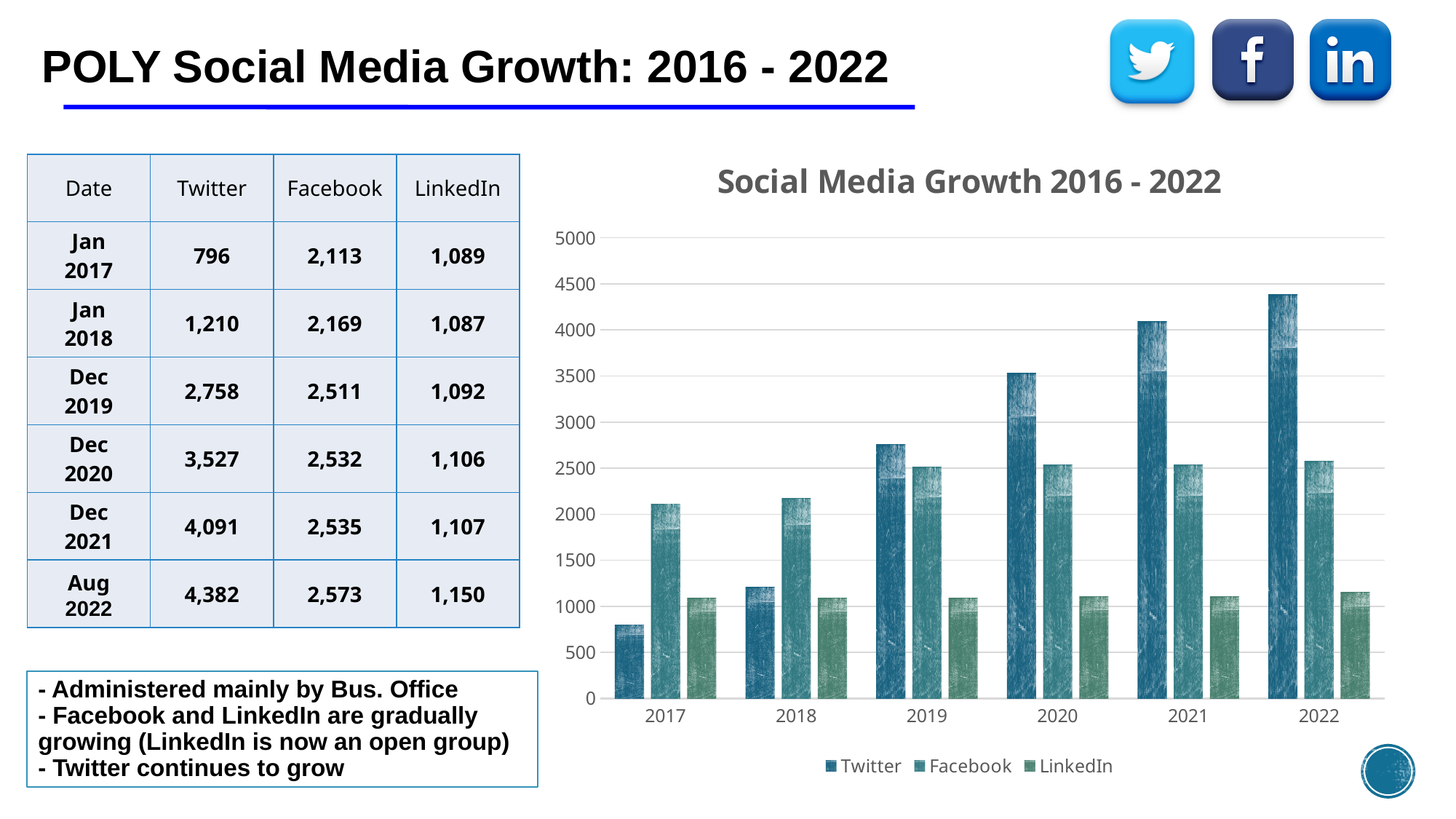
In 2017, which is larger, the Twitter bar or the Facebook bar? Facebook According to the table, what is the Twitter value for Aug 2022? 4,382 Which year has the lowest Twitter bar? 2017 Which year has the highest Twitter bar? 2022 Do the Twitter values rise or fall from 2017 to 2022? rise Is the Facebook value for 2017 greater or less than 2500? less What is the title of the chart? Social Media Growth 2016 - 2022 Is the Twitter value for 2021 greater or less than 4000? greater How many years are shown along the x axis of the chart? 6 In 2020, which is larger, the Twitter bar or the LinkedIn bar? Twitter What kind of chart is shown on the slide? bar chart How many series does the chart legend list? 3